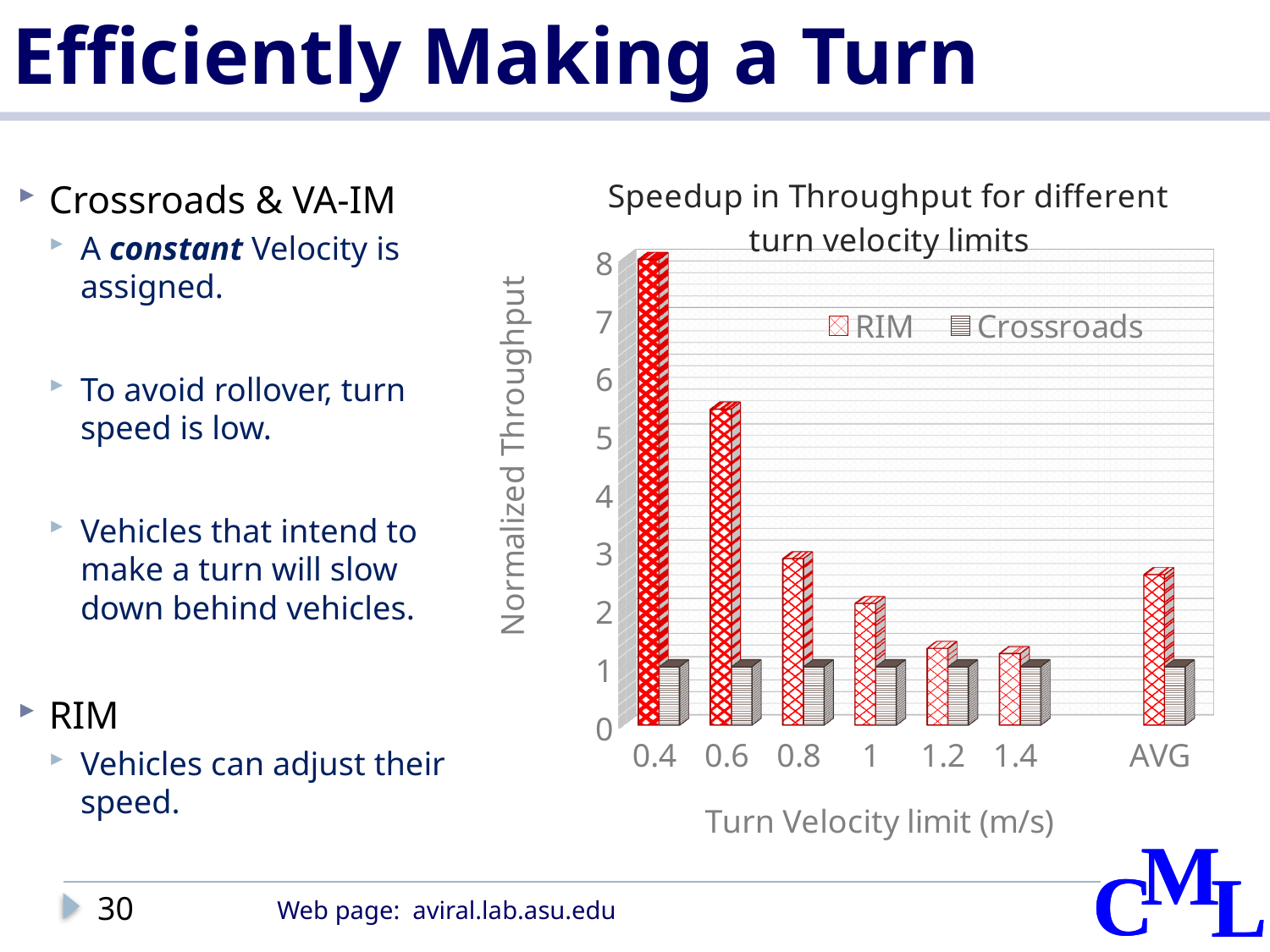
How many categories are shown along the x axis of the chart? 7 What is the title of the chart? Speedup in Throughput for different turn velocity limits Is the RIM value for a turn velocity limit of 1.2 greater or less than 2? less What is the label of the chart's x axis? Turn Velocity limit (m/s) Which is larger, the RIM value at a turn velocity limit of 0.6 or at 0.8? 0.6 Is the RIM value for AVG greater or less than 2? greater Which turn velocity limit has the highest RIM normalized throughput? 0.4 Do the RIM values rise or fall as the turn velocity limit increases from 0.4 to 1.4? fall What kind of chart is shown on the slide? bar chart Is the RIM value for a turn velocity limit of 0.6 greater or less than 5? greater How many series does the chart legend list? 2